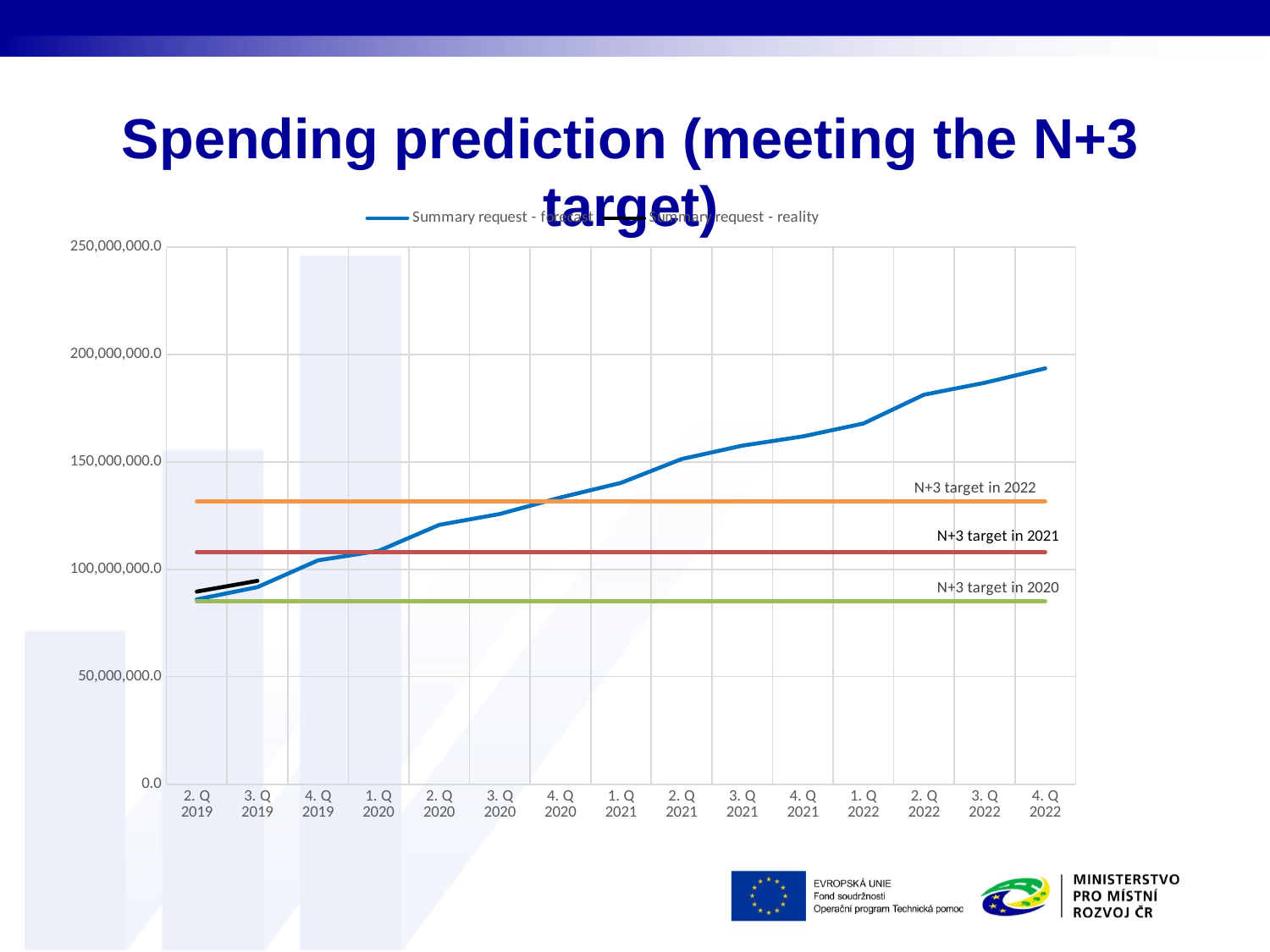
Does the 'Summary request - forecast' line rise or fall from 2. Q 2019 to 4. Q 2022? rise Is the 'N+3 target in 2020' line greater or less than 100,000,000.0? less Which is higher, the 'N+3 target in 2022' line or the 'N+3 target in 2020' line? N+3 target in 2022 In which quarter does the 'Summary request - forecast' line reach its highest value? 4. Q 2022 What kind of chart is shown on the slide? line chart How many quarters are shown on the x axis of the chart? 15 What are the two series named in the chart legend? Summary request - forecast; Summary request - reality In which quarter does the 'Summary request - forecast' line have its lowest value? 2. Q 2019 Is the 'Summary request - forecast' value for 2. Q 2019 greater or less than 100,000,000.0? less How many series does the chart legend list? 2 Is the 'N+3 target in 2022' line greater or less than 100,000,000.0? greater